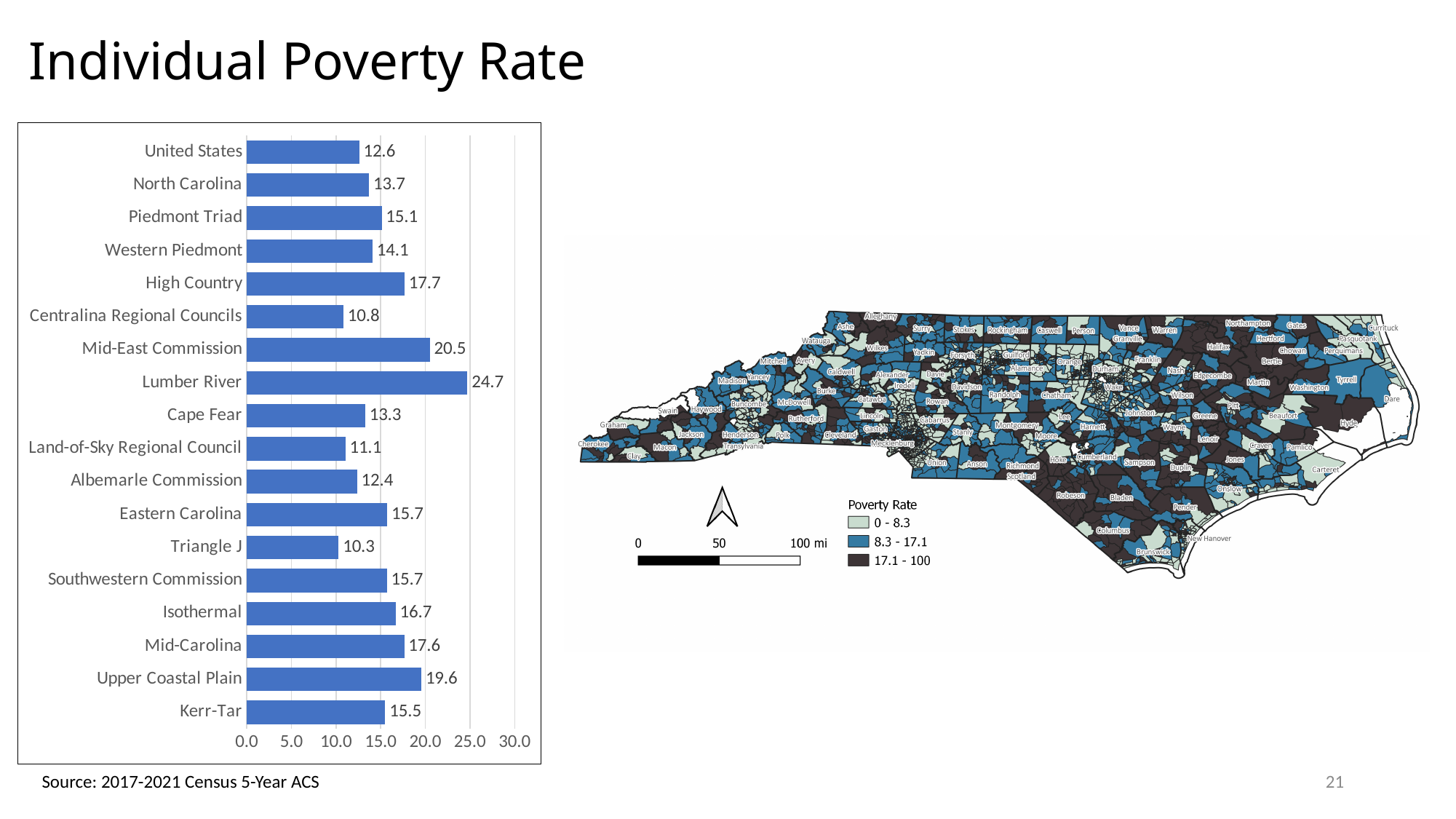
In the bar chart, what is the value shown for Centralina Regional Councils? 10.8 In the bar chart, what is the difference between the values for Mid-East Commission and Cape Fear? 7.2 In the bar chart, what is the individual poverty rate for Lumber River? 24.7 In the bar chart, which has a higher value, Isothermal or Albemarle Commission? Isothermal In the bar chart, which has a higher value, High Country or Western Piedmont? High Country In the bar chart, what is the value shown for North Carolina? 13.7 In the bar chart, which category has the highest poverty rate? Lumber River In the bar chart, what is the difference between the values for Upper Coastal Plain and United States? 7.0 In the bar chart, which category has the lowest poverty rate? Triangle J How many categories are shown in the bar chart? 18 What type of chart is shown on the left of the slide? Bar chart In the bar chart, is the value for Kerr-Tar greater or less than 20.0? less